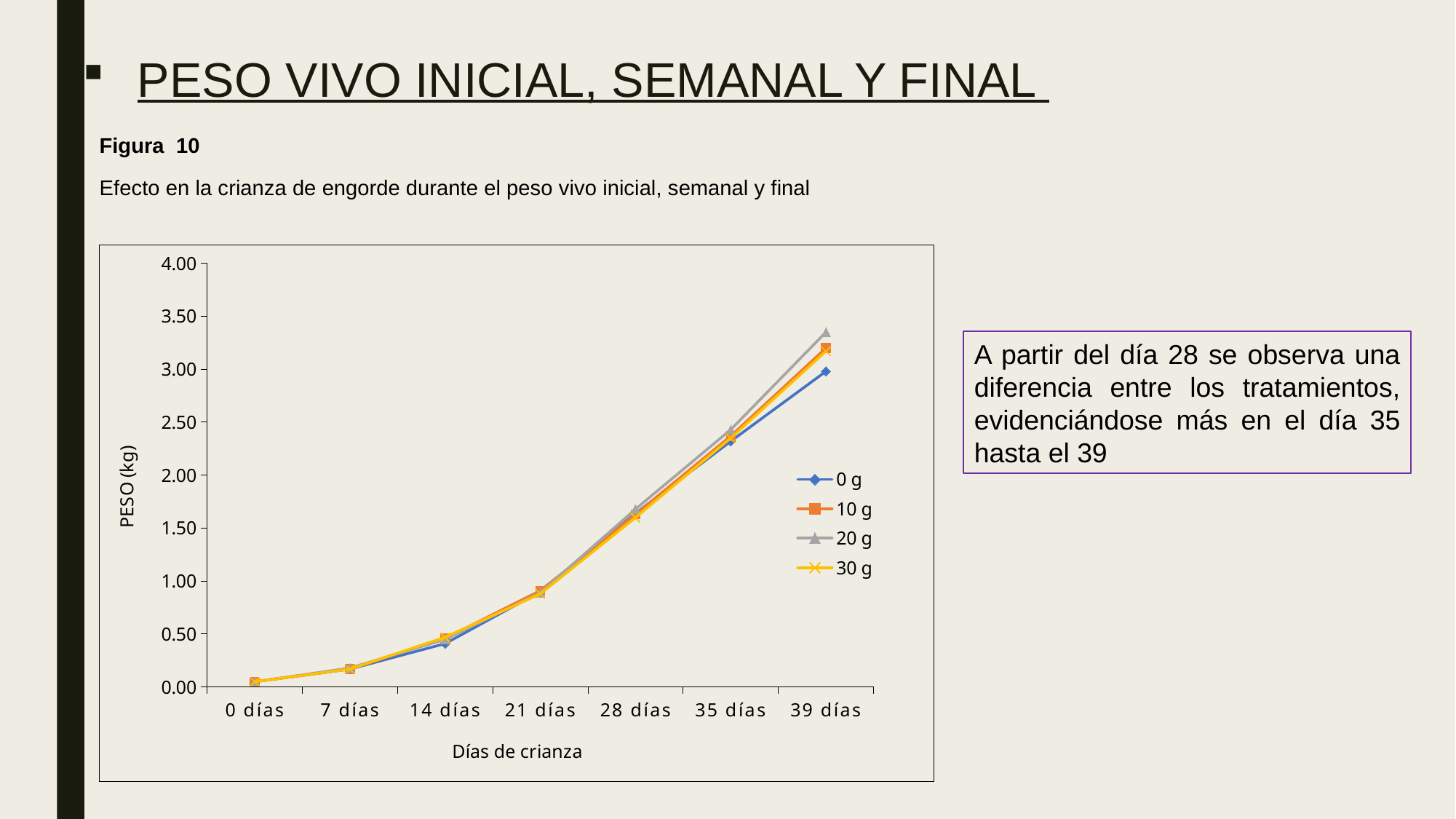
Do the values rise or fall as the days of rearing increase along the x axis? rise Is the value for 0 g at 14 días greater or less than 0.50? less What kind of chart is shown on the slide? line chart Is the value for 10 g at 28 días greater or less than 1.50? greater What is the label of the y axis of the chart? PESO (kg) At 39 días, which is larger: the value for 20 g or the value for 0 g? 20 g Is the value for 30 g at 35 días greater or less than 2.50? less How many series does the chart legend list? 4 How many points along the x axis (Días de crianza) does the chart show? 7 Which series has the lowest value at 39 días? 0 g Which series has the highest value at 39 días? 20 g